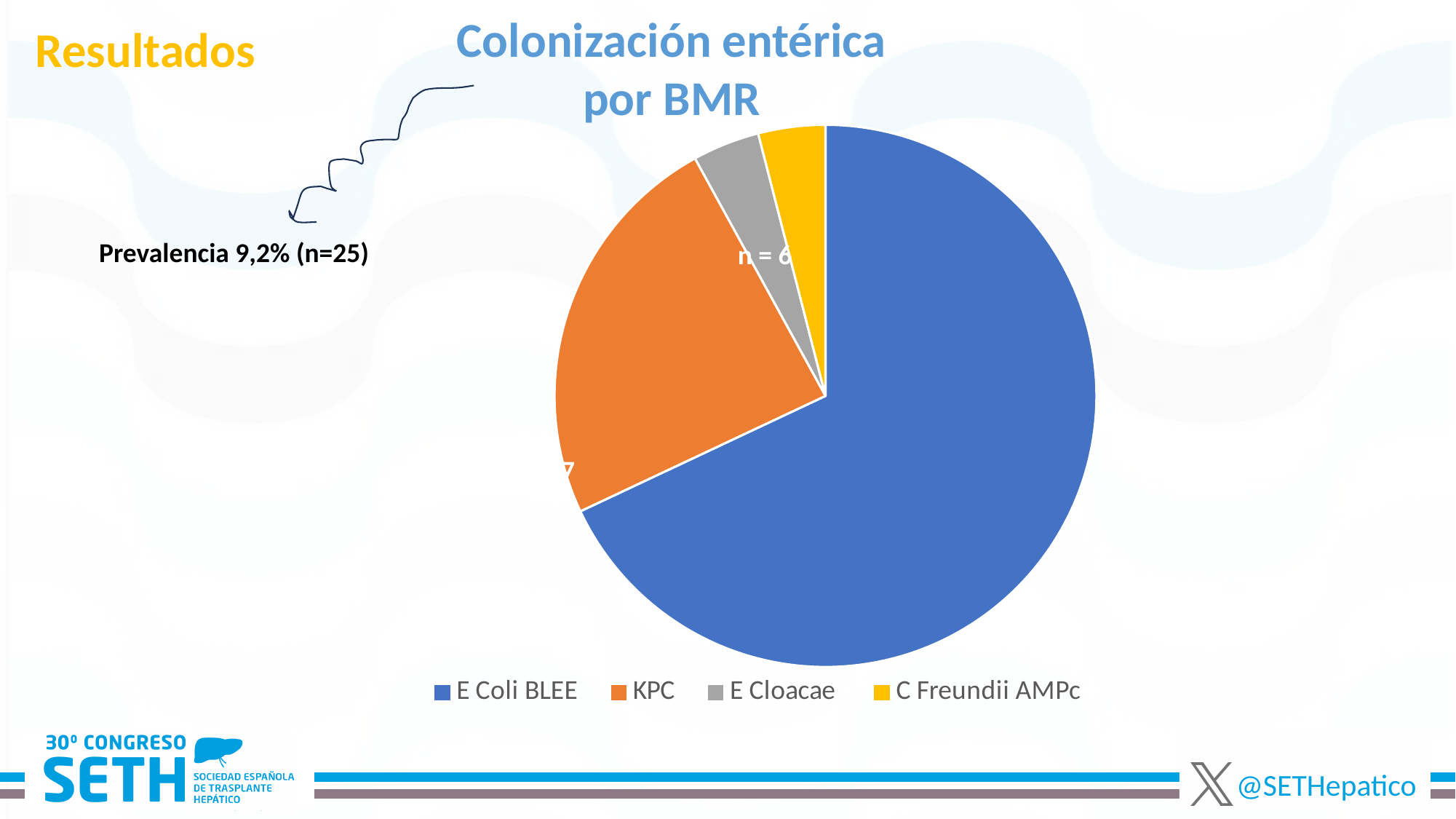
How many categories does the legend of the pie chart list? 4 Does the E Coli BLEE slice take up more or less than half of the pie? more Which category has the largest slice of the pie chart? E Coli BLEE Which slice is larger, KPC or C Freundii AMPc? KPC Which slice is larger, KPC or E Cloacae? KPC What kind of chart is shown on the slide? Pie chart What is the title of the chart? Colonización entérica por BMR Which slice is larger, E Coli BLEE or KPC? E Coli BLEE How many slices does the pie chart have? 4 Which colour represents KPC in the pie chart? Orange